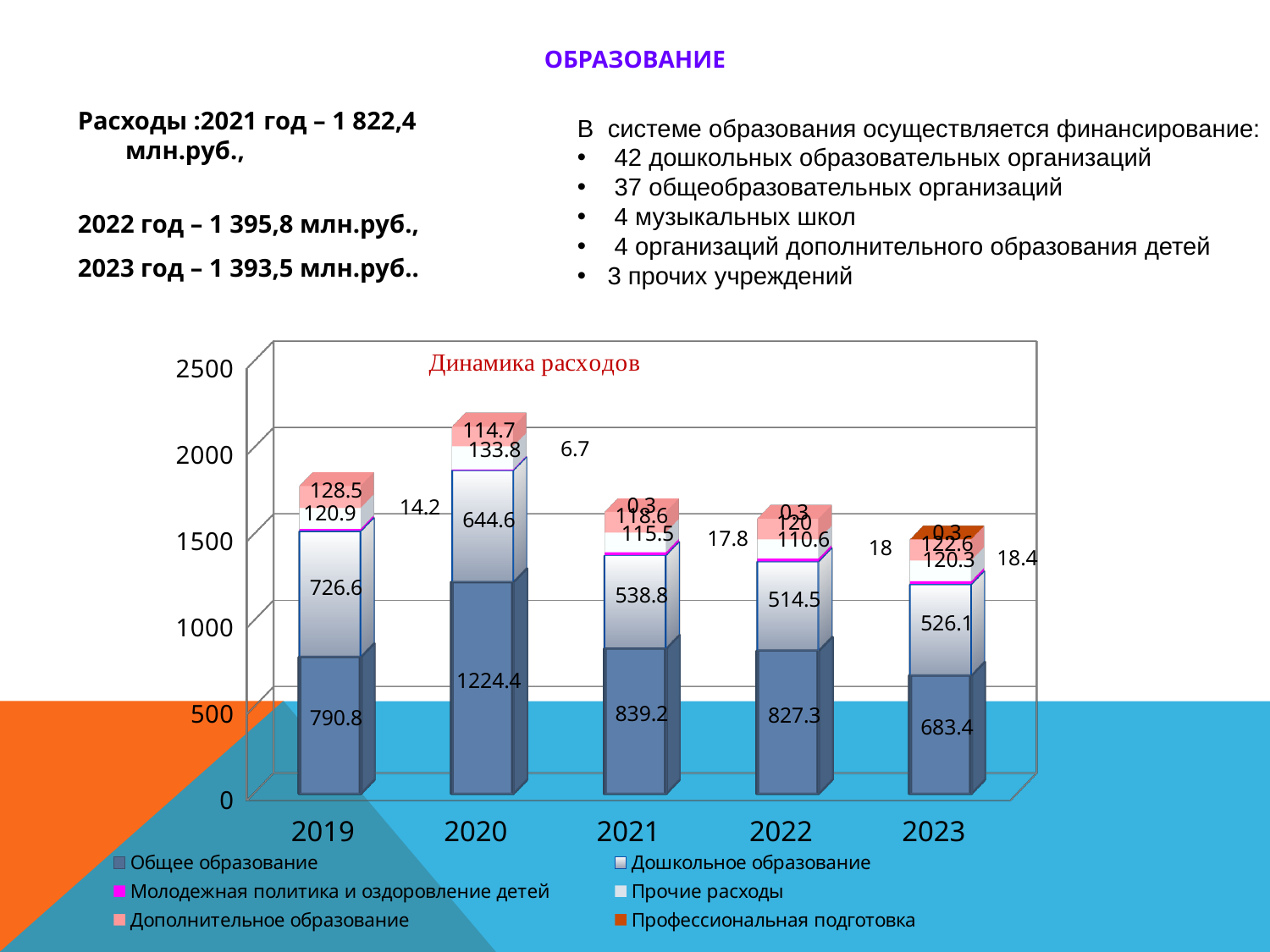
In which year is Общее образование highest? 2020 Is the total height of the 2020 stacked bar greater or less than 2000? greater What kind of chart is shown? stacked bar chart In which year is Общее образование lowest? 2023 What is the value for Дошкольное образование in 2019? 726.6 What is the difference between Общее образование in 2021 and in 2022? 11.9 What is the value for Общее образование in 2020? 1224.4 How many years are shown on the x axis? 5 How many series does the legend list? 6 Which is larger: Дошкольное образование in 2019 or in 2020? 2019 What is the value for Дошкольное образование in 2022? 514.5 What is the value for Общее образование in 2023? 683.4